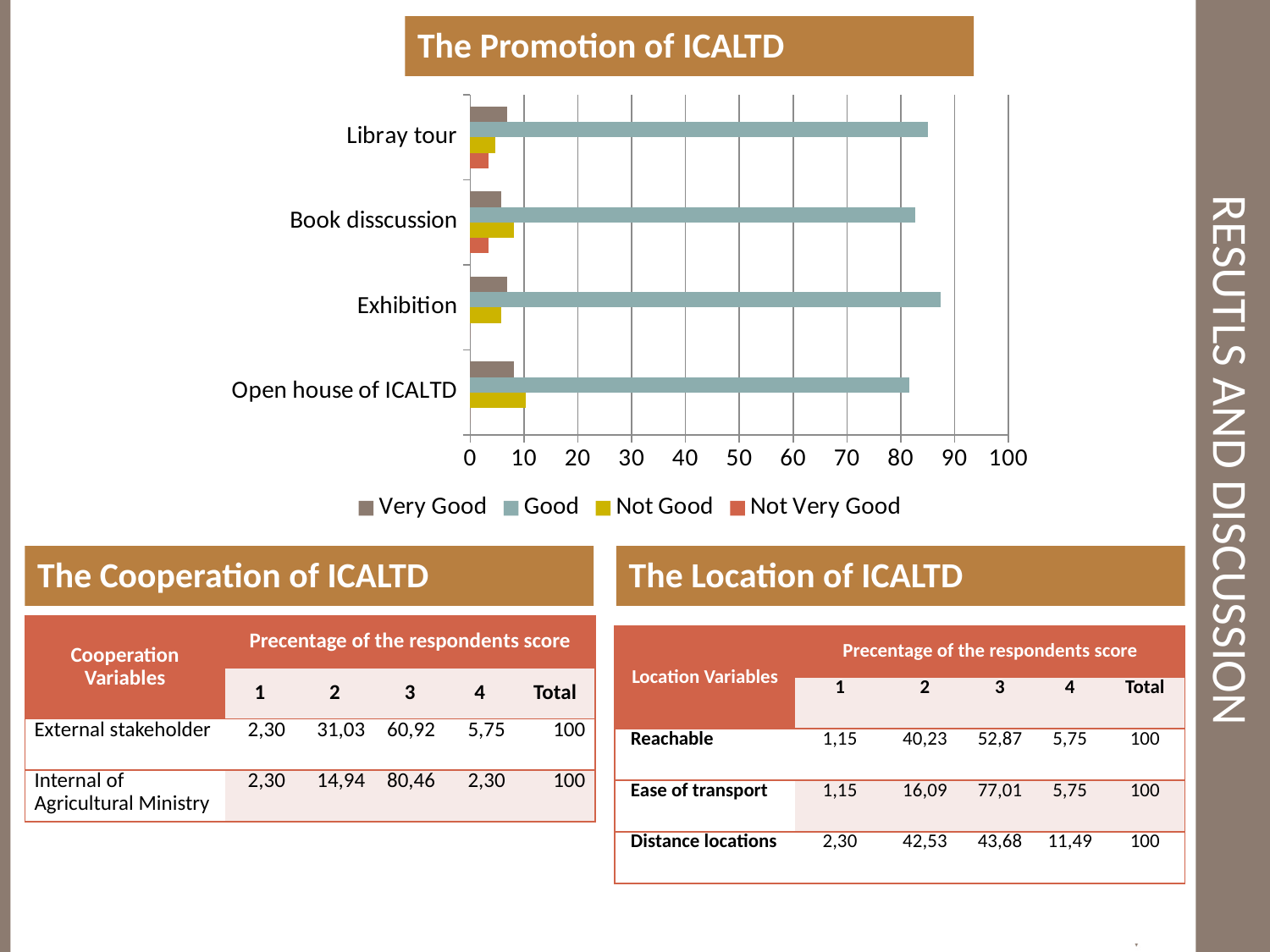
How many categories are plotted on the 'The Promotion of ICALTD' chart? 4 In the 'The Promotion of ICALTD' chart, is the 'Not Good' value for Open house of ICALTD greater or less than 20? less In the 'The Promotion of ICALTD' chart, is the 'Very Good' value for Exhibition greater or less than 10? less In the 'The Promotion of ICALTD' chart, is the 'Good' value for Book disscussion greater or less than 50? greater Which legend entry of the 'The Promotion of ICALTD' chart is shown in yellow? Not Good In the 'The Promotion of ICALTD' chart, which series has the largest value for Exhibition? Good What is the title of the bar chart on the slide? The Promotion of ICALTD What kind of chart is shown under the title 'The Promotion of ICALTD'? bar chart In the 'The Promotion of ICALTD' chart, which is larger for Open house of ICALTD: 'Good' or 'Very Good'? Good How many series does the legend of the 'The Promotion of ICALTD' chart list? 4 In the 'The Promotion of ICALTD' chart, which is larger for Book disscussion: 'Not Good' or 'Not Very Good'? Not Good